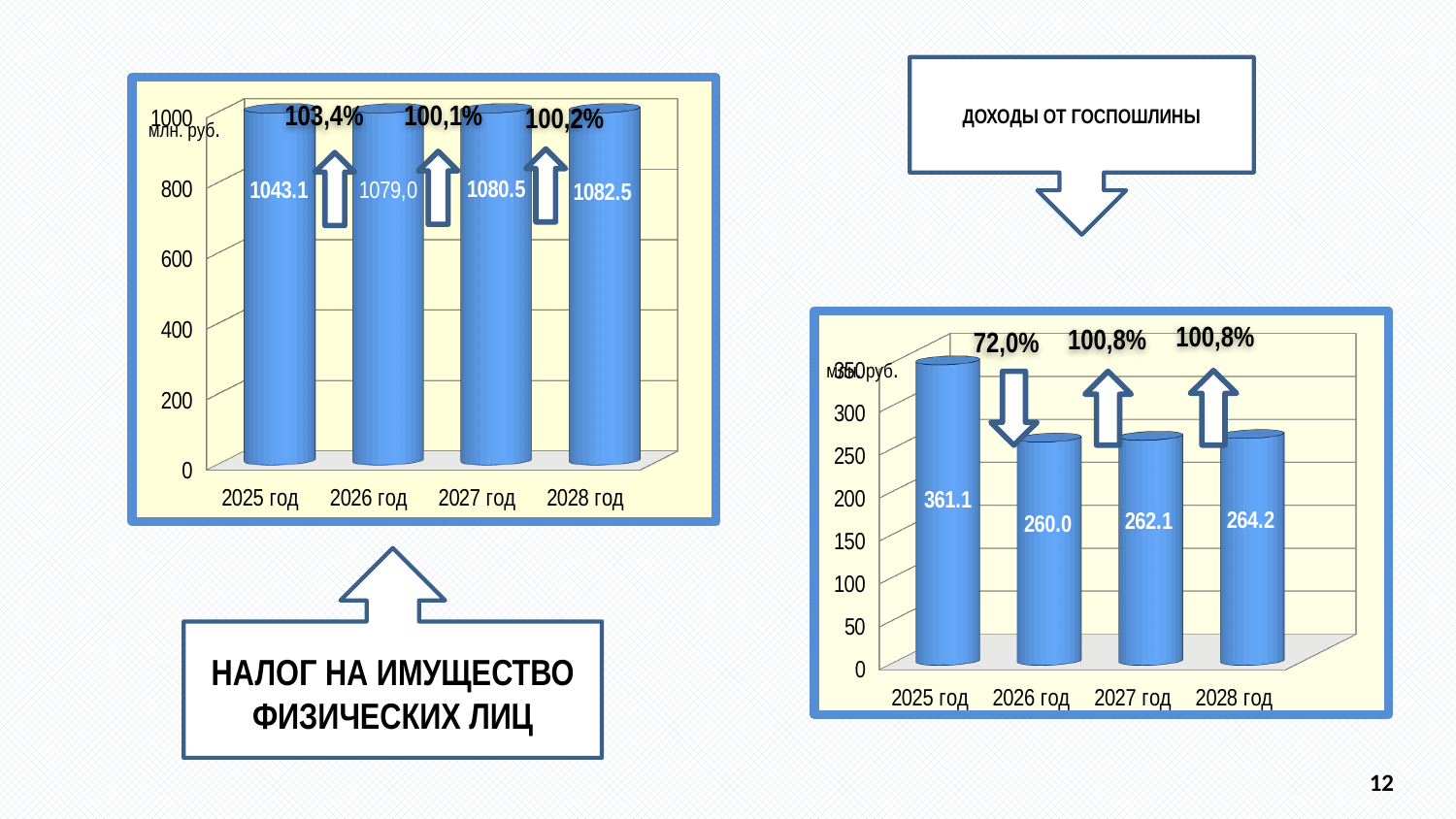
In the chart for 'Доходы от госпошлины' (right), what is the difference between the values for 2025 год and 2026 год? 101.1 In the chart for 'Доходы от госпошлины' (right), is the value for 2026 год greater or less than 300? less How many years are shown on the x axis of the chart for 'Налог на имущество физических лиц' (left)? 4 In the chart for 'Налог на имущество физических лиц' (left), what is the value for 2028 год? 1082.5 In the chart for 'Доходы от госпошлины' (right), what is the value for 2026 год? 260.0 What kind of chart is the chart for 'Доходы от госпошлины' (right)? bar chart In the chart for 'Доходы от госпошлины' (right), which year has the highest value? 2025 год In the chart for 'Налог на имущество физических лиц' (left), what is the value for 2025 год? 1043.1 In the chart for 'Доходы от госпошлины' (right), which year has the lowest value? 2026 год In the chart for 'Доходы от госпошлины' (right), what is the value for 2028 год? 264.2 In the chart for 'Налог на имущество физических лиц' (left), what is the difference between the values for 2028 год and 2025 год? 39.4 In the chart for 'Налог на имущество физических лиц' (left), which year has the lowest value? 2025 год